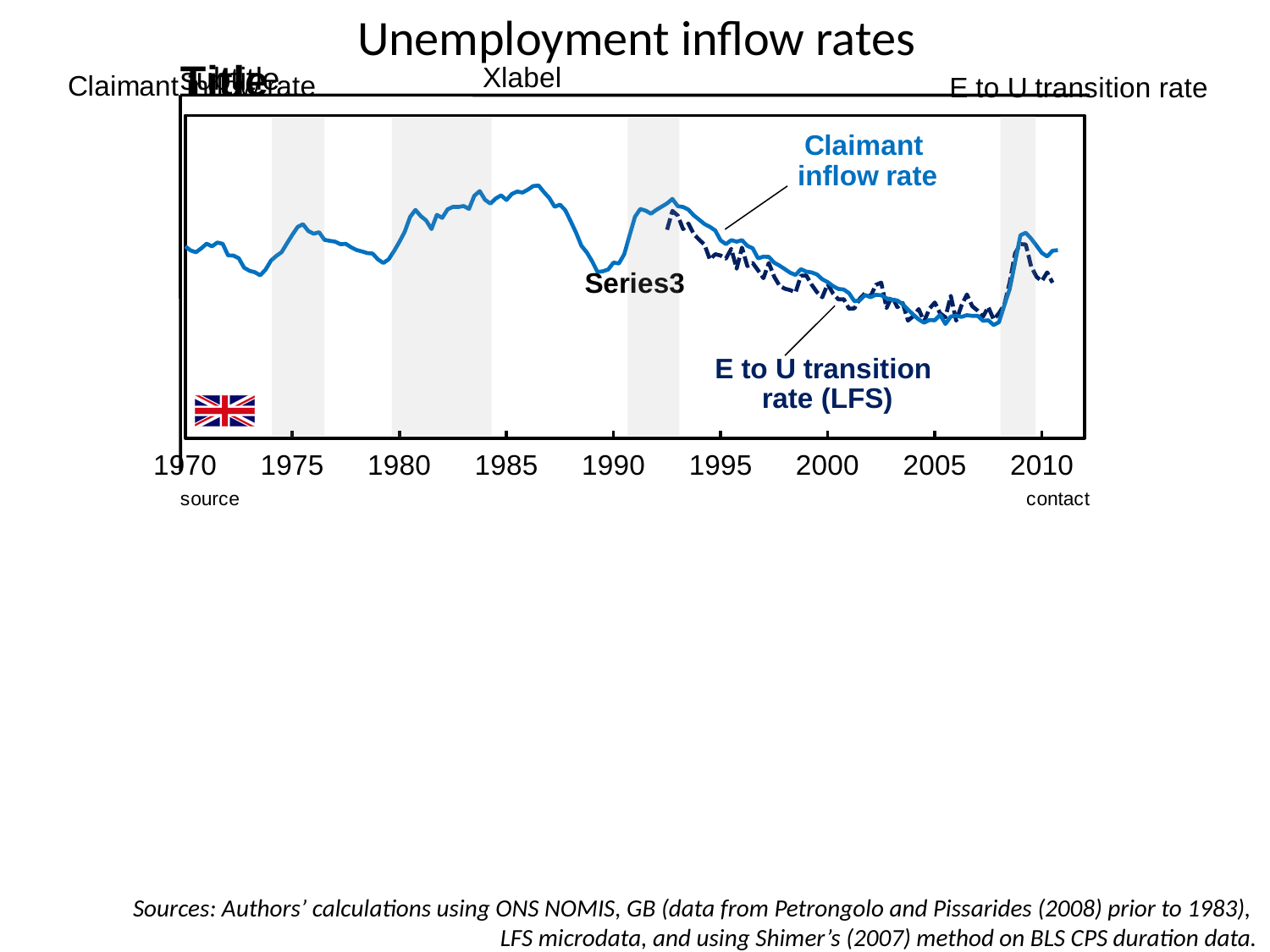
Around 1993, which series is higher, the Claimant inflow rate or the E to U transition rate (LFS)? Claimant inflow rate What is the last year labelled on the x axis? 2010 Does the Claimant inflow rate rise or fall between 1986 and 1990? fall How many year labels are shown on the x axis? 9 Which series begins earlier on the x axis, the Claimant inflow rate or the E to U transition rate (LFS)? Claimant inflow rate Which series is drawn as a dashed line? E to U transition rate (LFS) Does the Claimant inflow rate rise or fall between 2007 and 2009? rise Does the Claimant inflow rate rise or fall overall between 1993 and 2004? fall What kind of chart is shown on the slide? line chart What is the title of the chart? Unemployment inflow rates What is the first year labelled on the x axis? 1970